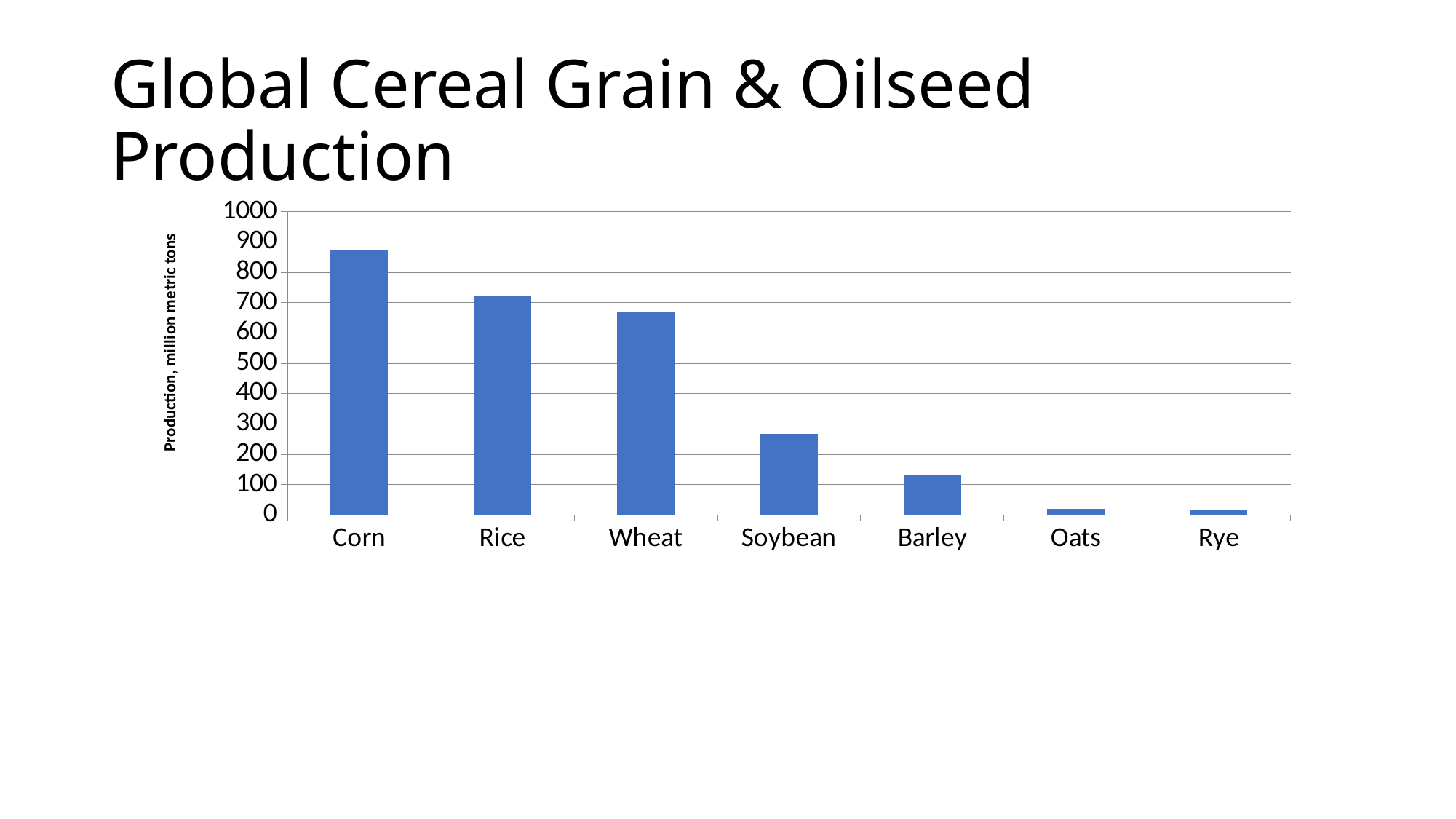
Which is larger, the value for Rice or the value for Wheat? Rice Is the value for Oats greater or less than 100? less Which category has the highest production? Corn Is the value for Barley greater or less than 100? greater Is the value for Corn greater or less than 800? greater What is the label on the vertical axis of the chart? Production, million metric tons What kind of chart is shown on the slide? bar chart Do the values rise or fall moving from Corn to Rye along the x axis? fall How many categories are plotted on the chart? 7